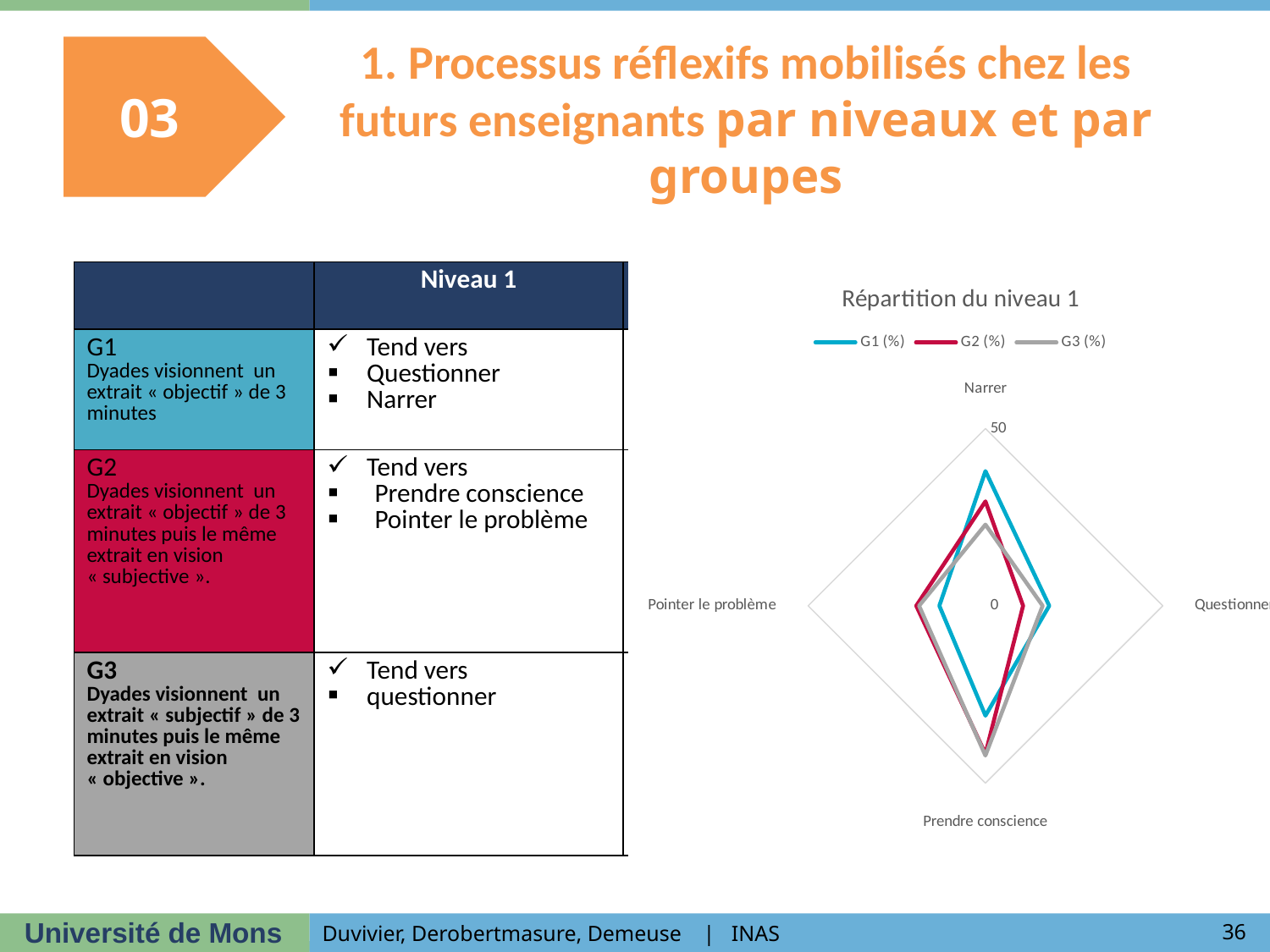
Which series are listed in the chart legend? G1 (%), G2 (%), G3 (%) What is the title of the chart on the slide? Répartition du niveau 1 Is the value of G1 (%) for Narrer greater or less than 50? less How many series does the chart legend list? 3 For the Narrer axis, which series has the larger value, G1 (%) or G3 (%)? G1 (%) What type of chart is shown on the slide? Radar chart On which axis does the G3 (%) series reach its highest value? Prendre conscience How many categories (axes) does the radar chart have? 4 For the Questionner axis, which series has the larger value, G1 (%) or G2 (%)? G1 (%) On which axis does the G1 (%) series reach its highest value? Narrer For the Prendre conscience axis, which series has the larger value, G1 (%) or G3 (%)? G3 (%) Is the value of G3 (%) for Prendre conscience greater or less than 50? less